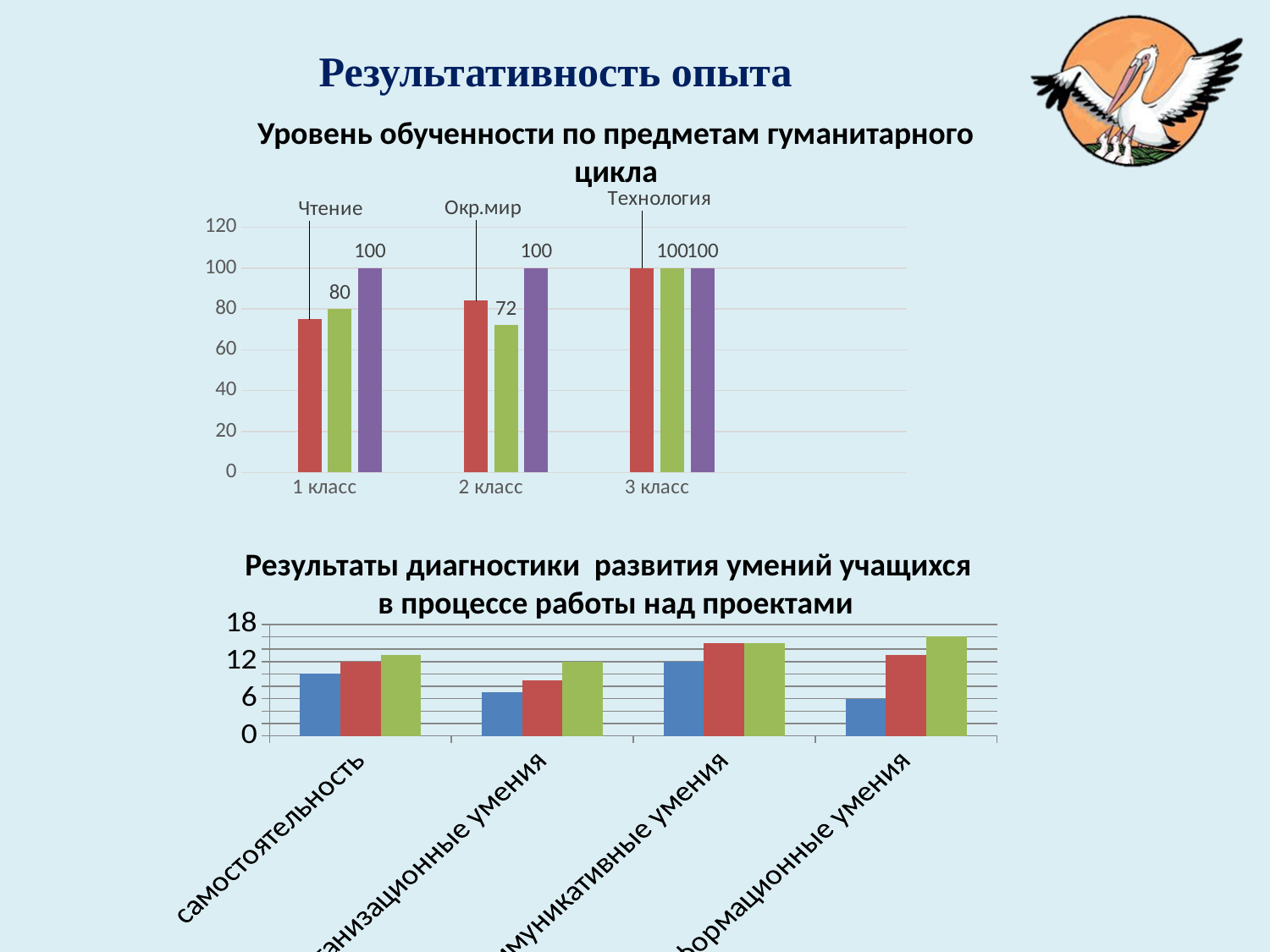
What kind of chart is the top chart, 'Уровень обученности по предметам гуманитарного цикла'? bar chart In the top chart 'Уровень обученности по предметам гуманитарного цикла', what is the value of the purple bar for 1 класс? 100 In the top chart 'Уровень обученности по предметам гуманитарного цикла', what is the value of the green bar for 1 класс? 80 In the top chart 'Уровень обученности по предметам гуманитарного цикла', is the red bar for 1 класс greater or less than 80? less In the bottom chart 'Результаты диагностики развития умений учащихся', how many categories are shown on the x axis? 4 In the top chart 'Уровень обученности по предметам гуманитарного цикла', how much higher is the green bar for 1 класс than the green bar for 2 класс? 8 In the top chart 'Уровень обученности по предметам гуманитарного цикла', what is the value of the green bar for 2 класс? 72 In the top chart 'Уровень обученности по предметам гуманитарного цикла', for which class is the green bar lowest? 2 класс In the bottom chart 'Результаты диагностики развития умений учащихся', is the blue bar for 'самостоятельность' greater or less than 12? less What kind of chart is the bottom chart, 'Результаты диагностики развития умений учащихся в процессе работы над проектами'? bar chart In the top chart 'Уровень обученности по предметам гуманитарного цикла', what is the difference between the purple bar and the green bar for 1 класс? 20 In the top chart 'Уровень обученности по предметам гуманитарного цикла', how many class categories are shown on the x axis? 3